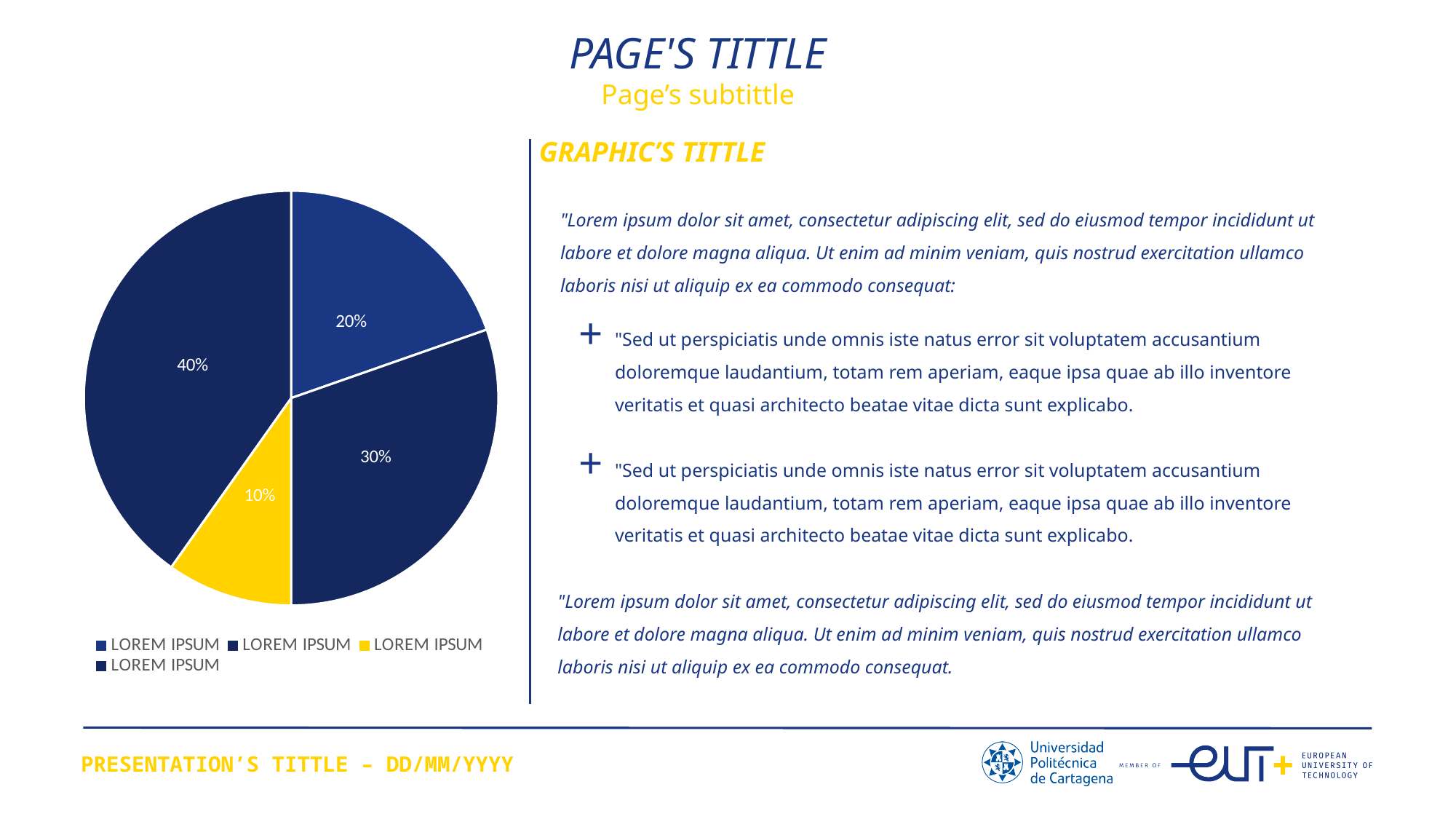
What is the value of the smallest slice in the pie chart? 10% What is the title shown above the text next to the pie chart? GRAPHIC'S TITTLE What colour is the smallest slice of the pie chart? yellow Which is larger in the pie chart, the yellow slice or the light blue slice? the light blue slice What share of the pie does the yellow slice represent? 10% What is the value of the yellow slice in the pie chart? 10% How many slices does the pie chart have? 4 What is the value of the largest slice in the pie chart? 40% How many entries does the legend of the pie chart list? 4 What kind of chart is shown on the slide? pie chart What is the difference between the largest slice and the smallest slice in the pie chart? 30% What is the difference between the 30% slice and the 20% slice in the pie chart? 10%